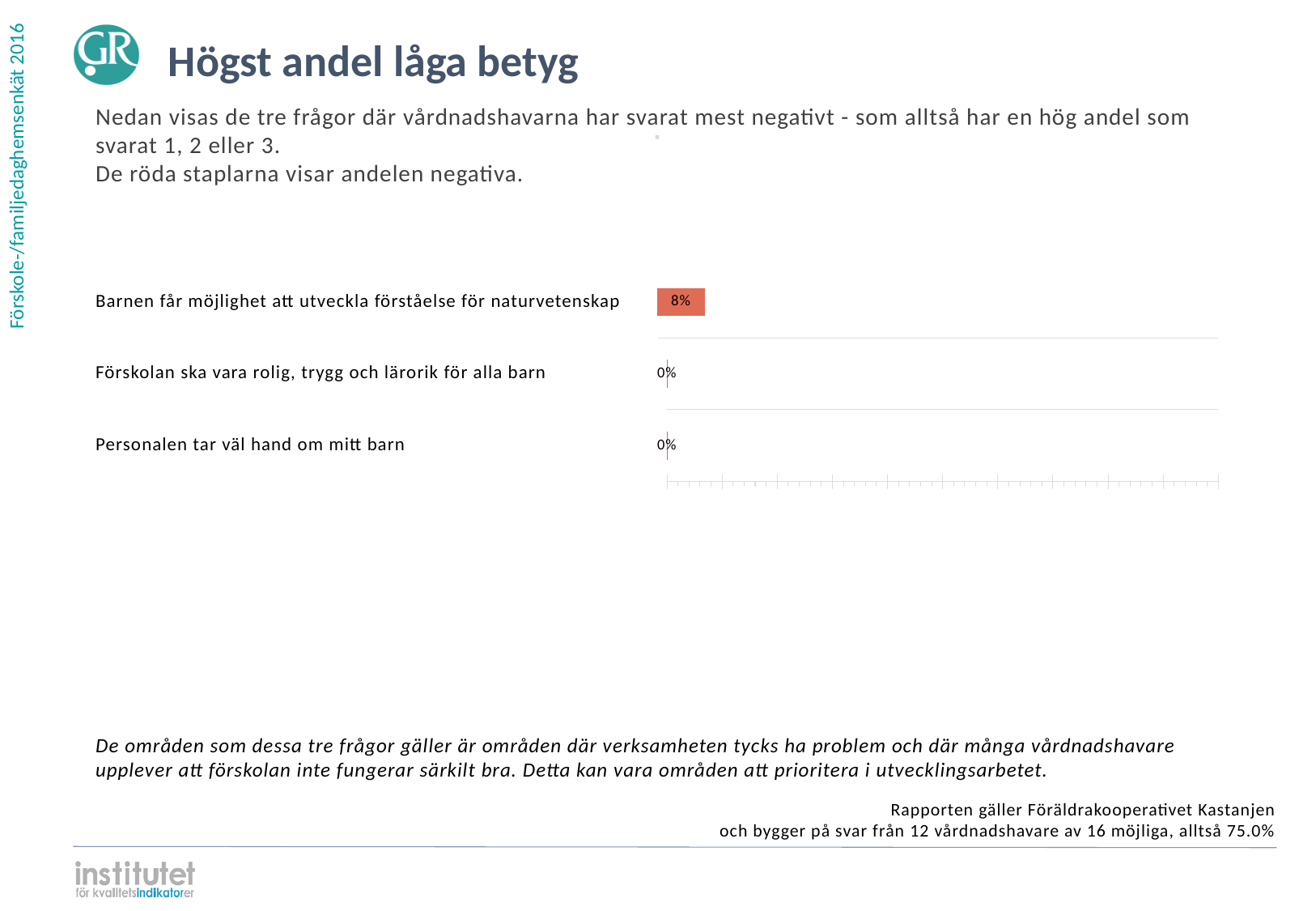
What colour are the bars in the chart? Red How many categories have a value of 0%? 2 Which category has the highest value? Barnen får möjlighet att utveckla förståelse för naturvetenskap What is the title of the slide? Högst andel låga betyg What kind of chart is shown on the slide? Bar chart What is the value for "Förskolan ska vara rolig, trygg och lärorik för alla barn"? 0% How many categories are shown in the chart? 3 What is the value for "Personalen tar väl hand om mitt barn"? 0% Which is larger: the value for "Barnen får möjlighet att utveckla förståelse för naturvetenskap" or the value for "Förskolan ska vara rolig, trygg och lärorik för alla barn"? Barnen får möjlighet att utveckla förståelse för naturvetenskap What is the difference between the value for "Barnen får möjlighet att utveckla förståelse för naturvetenskap" and the value for "Personalen tar väl hand om mitt barn"? 8% What is the value for "Barnen får möjlighet att utveckla förståelse för naturvetenskap"? 8%